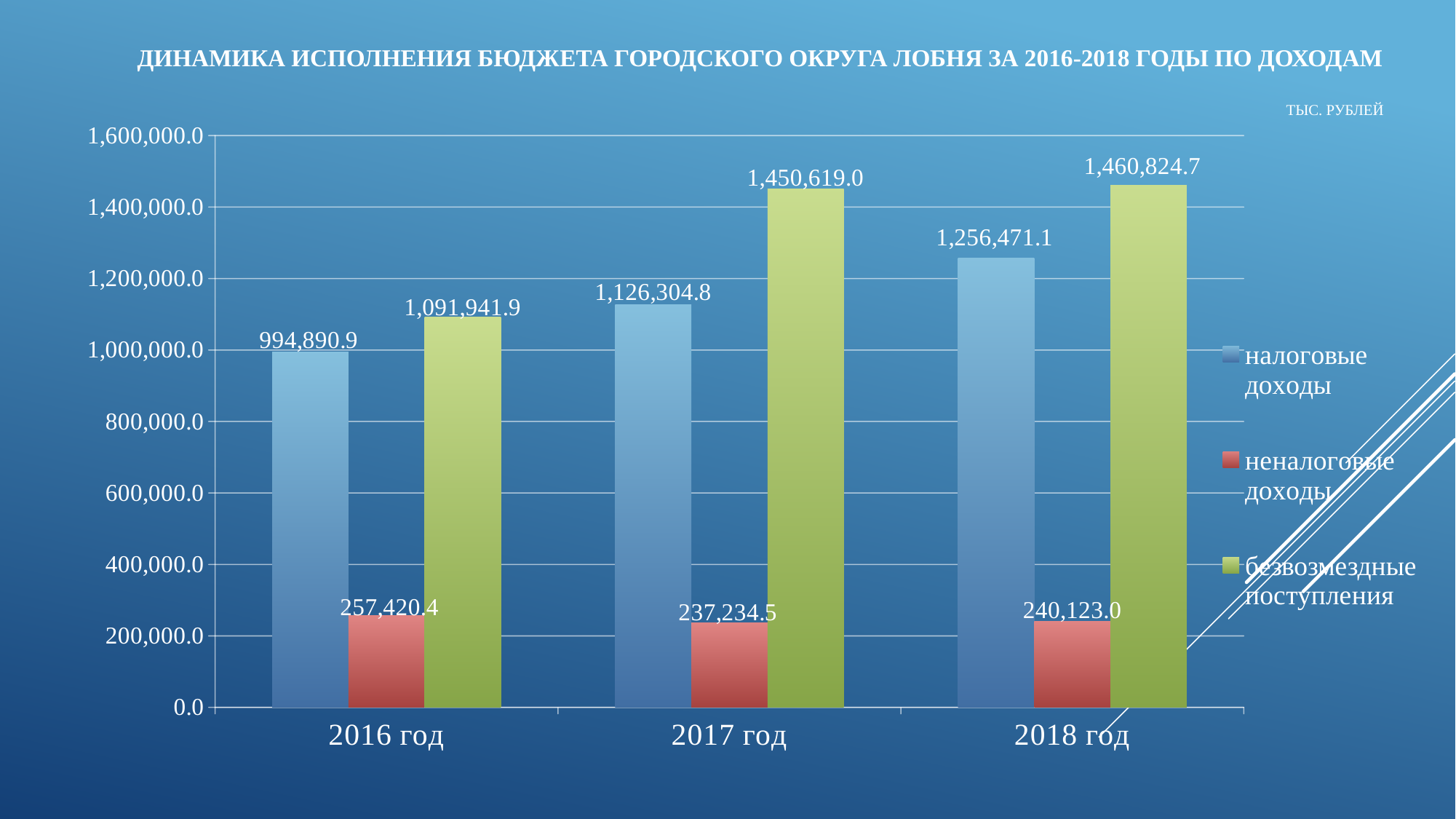
In which year is the value of неналоговые доходы the lowest? 2017 год How many series does the legend list? 3 What is the difference between неналоговые доходы in 2016 год and in 2017 год? 20,185.9 What is the value of неналоговые доходы for 2018 год? 240,123.0 What is the difference between налоговые доходы in 2018 год and in 2016 год? 261,580.2 Is the value of налоговые доходы for 2018 год greater or less than 1,200,000.0? greater What is the value of безвозмездные поступления for 2017 год? 1,450,619.0 In which year is the value of безвозмездные поступления the highest? 2018 год How many years are shown on the x axis? 3 What is the value of налоговые доходы for 2016 год? 994,890.9 Do the values of налоговые доходы rise or fall from 2016 год to 2018 год? rise Which is larger in 2017 год: налоговые доходы or безвозмездные поступления? безвозмездные поступления